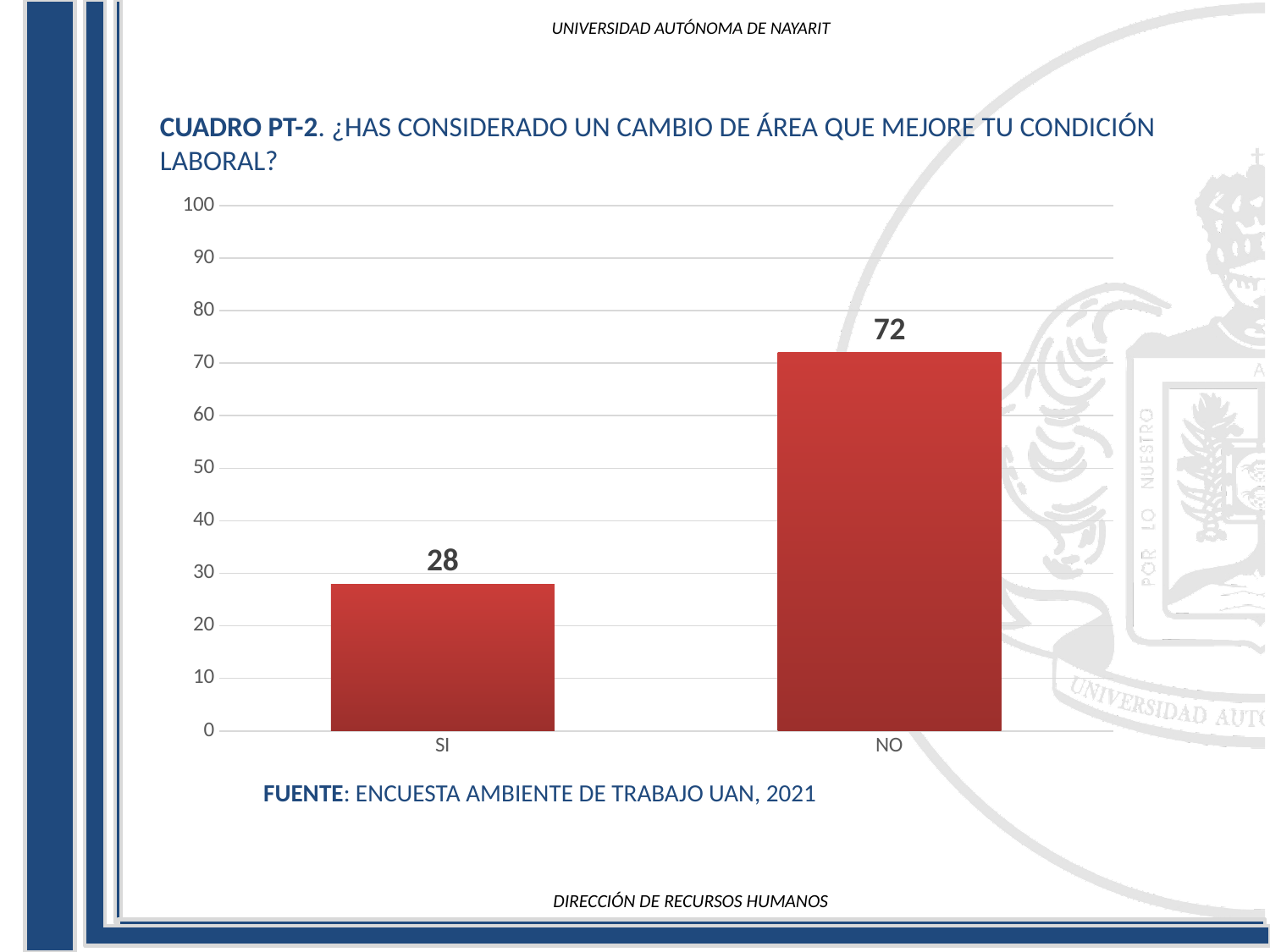
Which category has the lowest value? SI Which category has the highest value? NO Is the value for SI greater or less than 30? less What kind of chart is shown on the slide? bar chart What is the source cited below the chart? ENCUESTA AMBIENTE DE TRABAJO UAN, 2021 How many categories are shown on the x axis? 2 What is the highest value shown on the y axis? 100 Is the value for NO greater or less than 70? greater What is the difference between the values for NO and SI? 44 What is the value for NO? 72 What is the value for SI? 28 Which is larger, the value for SI or the value for NO? NO